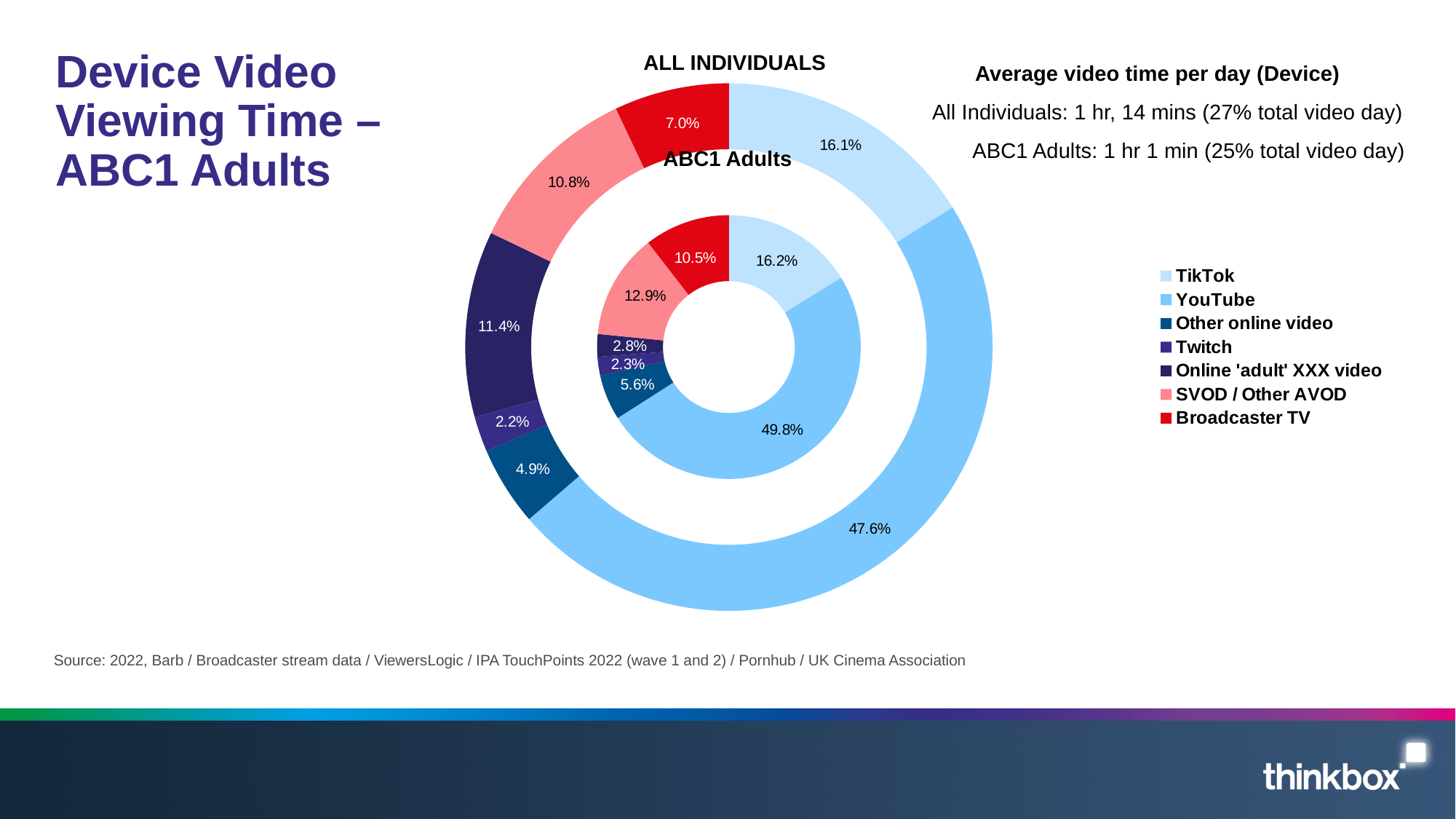
Which ring of the doughnut chart represents ABC1 Adults, the inner or the outer? Inner Which category has the largest share in the ABC1 Adults ring? YouTube What type of chart is shown on the slide? Doughnut chart What is the SVOD / Other AVOD share for All Individuals in the outer ring? 10.8% What is the Broadcaster TV share for ABC1 Adults in the inner ring? 10.5% What is the TikTok share for All Individuals in the outer ring? 16.1% What is the difference between the Broadcaster TV share for ABC1 Adults (10.5%) and for All Individuals (7.0%)? 3.5% Which is larger: the Online 'adult' XXX video share for All Individuals or for ABC1 Adults? All Individuals How many categories does the legend list? 7 Which category has the smallest share in the All Individuals ring? Twitch What share of device video viewing time does YouTube account for among All Individuals (outer ring)? 47.6% What share of device video viewing time does YouTube account for among ABC1 Adults (inner ring)? 49.8%